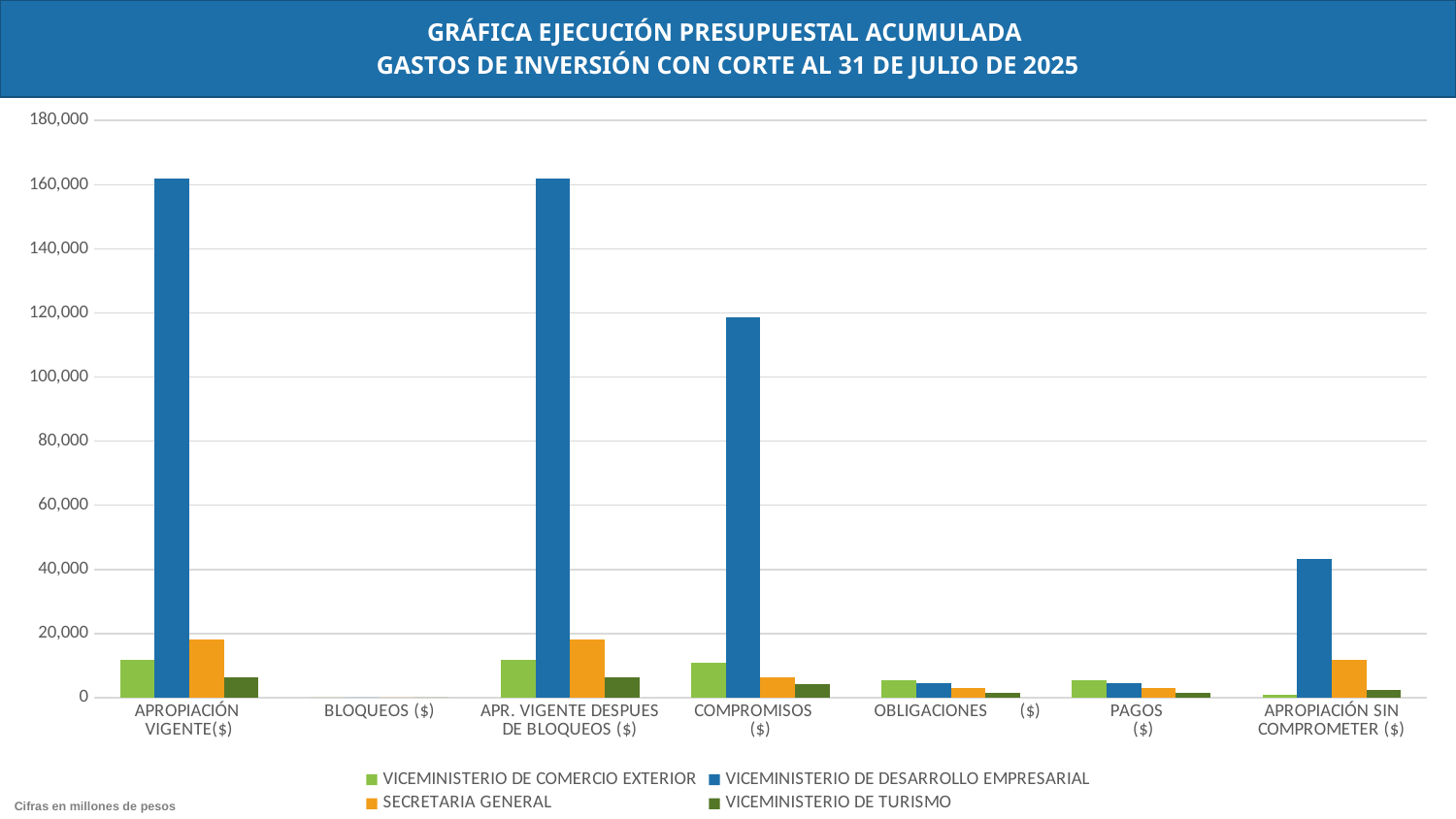
What kind of chart is shown on the slide? bar chart Is the value for VICEMINISTERIO DE DESARROLLO EMPRESARIAL in APROPIACIÓN SIN COMPROMETER ($) greater or less than 60,000? less Which series has the highest value in the COMPROMISOS ($) category? VICEMINISTERIO DE DESARROLLO EMPRESARIAL In APROPIACIÓN SIN COMPROMETER ($), which is larger: SECRETARIA GENERAL or VICEMINISTERIO DE TURISMO? SECRETARIA GENERAL How many series does the legend list? 4 According to the note at the bottom left of the slide, in what units are the figures expressed? millones de pesos How many categories are shown along the x axis? 7 Which category has the lowest values across all series? BLOQUEOS ($) Is the value for VICEMINISTERIO DE DESARROLLO EMPRESARIAL in APROPIACIÓN VIGENTE($) greater or less than 140,000? greater Is the value for VICEMINISTERIO DE DESARROLLO EMPRESARIAL in COMPROMISOS ($) greater or less than 100,000? greater In APROPIACIÓN VIGENTE($), which is larger: VICEMINISTERIO DE COMERCIO EXTERIOR or SECRETARIA GENERAL? SECRETARIA GENERAL